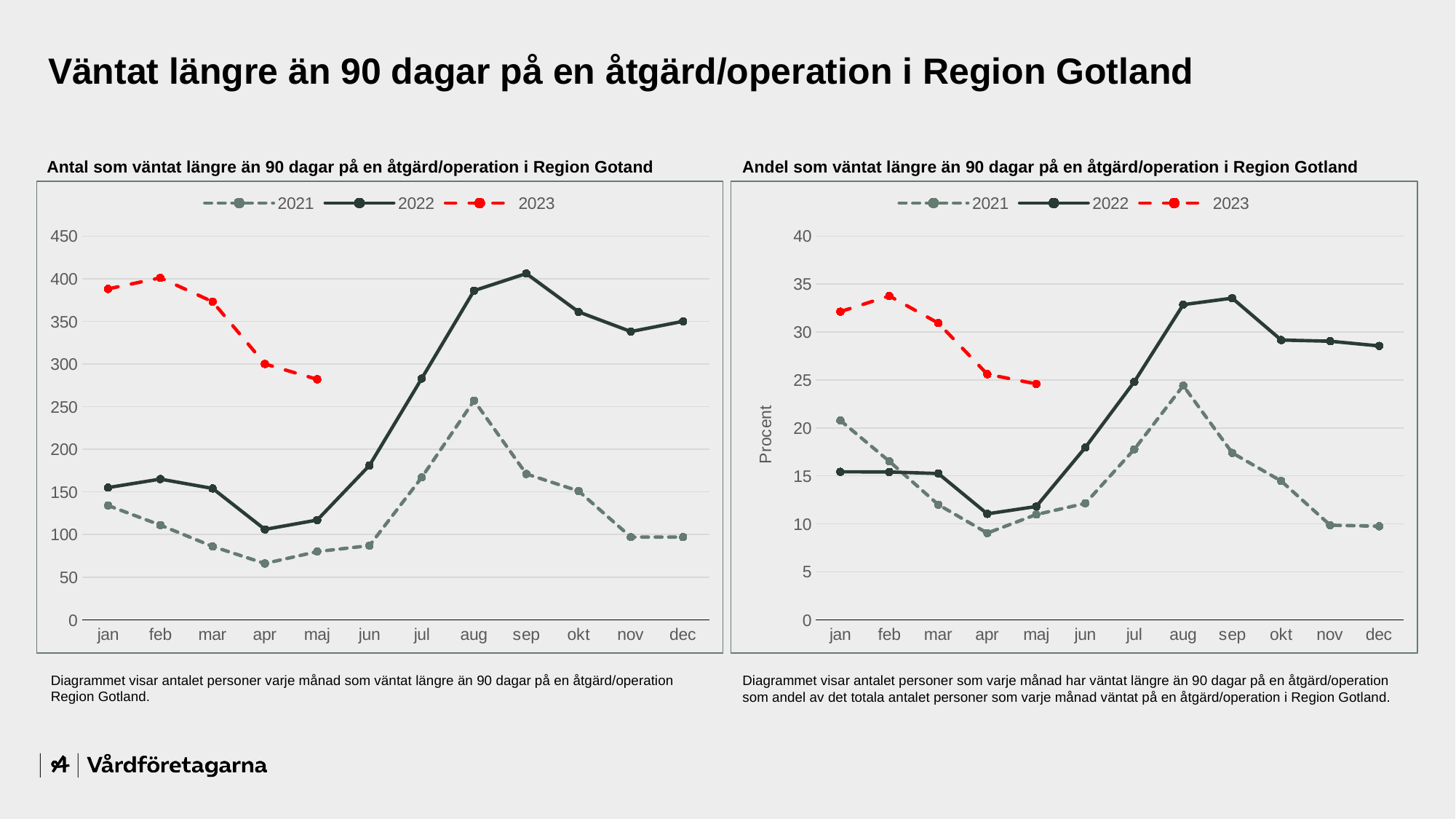
In the right chart (Andel som väntat längre än 90 dagar), what is the label on the y axis? Procent In the left chart (Antal som väntat längre än 90 dagar), in which month does the 2022 series reach its highest value? sep In the left chart (Antal som väntat längre än 90 dagar), in which month does the 2021 series reach its lowest value? apr In the left chart (Antal som väntat längre än 90 dagar), does the 2023 series rise or fall from jan to maj? fall In the right chart (Andel som väntat längre än 90 dagar), is the 2022 value for aug greater or less than 30? greater In the left chart (Antal som väntat längre än 90 dagar), how many months are shown on the x axis? 12 In the left chart (Antal som väntat längre än 90 dagar), what kind of chart is shown? line chart In the left chart (Antal som väntat längre än 90 dagar), how many series does the legend list? 3 In the left chart (Antal som väntat längre än 90 dagar), is the 2022 value for aug greater or less than 350? greater In the right chart (Andel som väntat längre än 90 dagar), in which month does the 2021 series reach its highest value? aug In the left chart (Antal som väntat längre än 90 dagar), which series has the higher value in aug, 2021 or 2022? 2022 In the right chart (Andel som väntat längre än 90 dagar), how many data points does the 2023 series have? 5